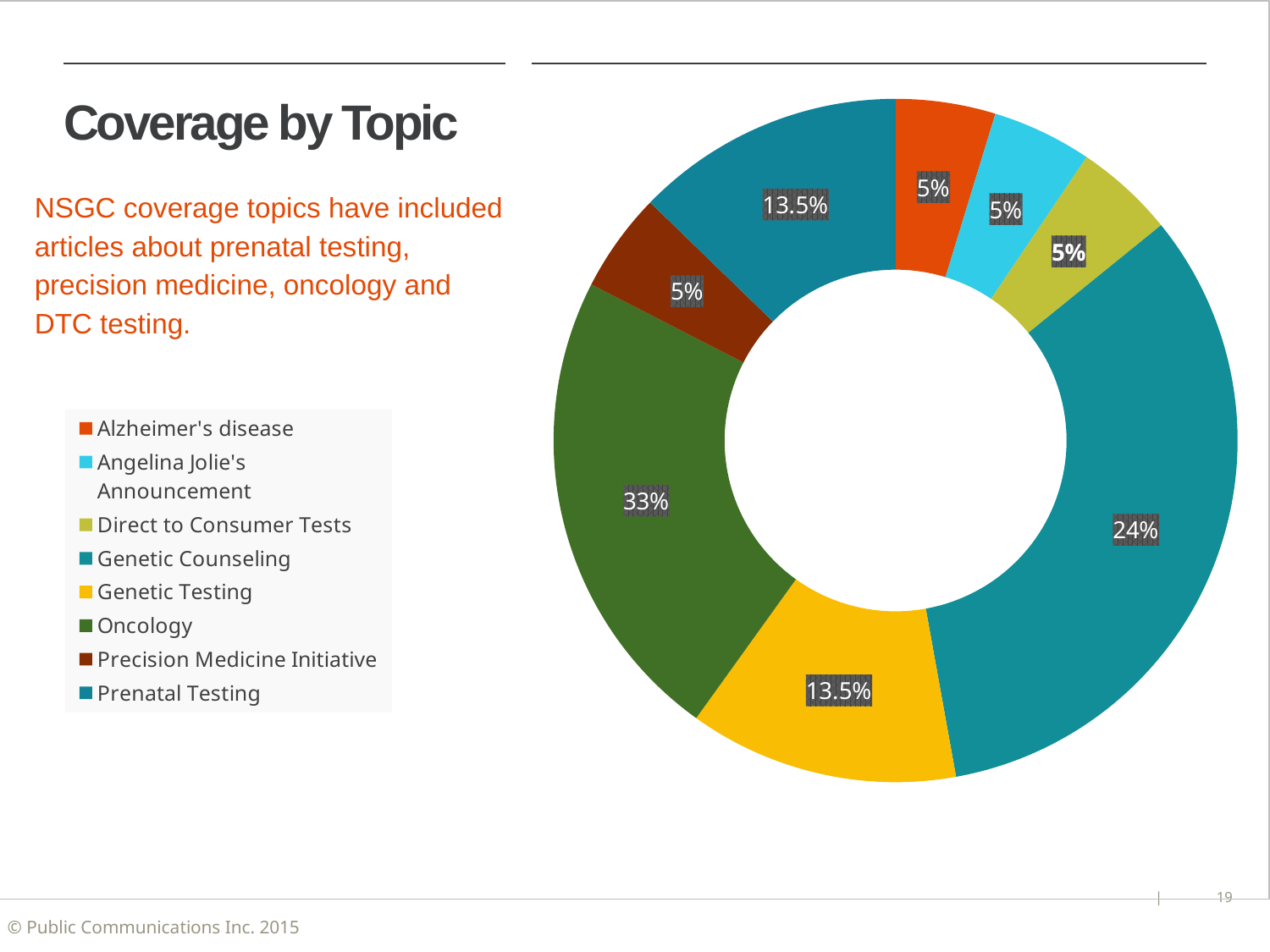
Which is larger, the share for Genetic Counseling or the share for Genetic Testing? Genetic Counseling What percentage is shown for Prenatal Testing? 13.5% What percentage is shown for Alzheimer's disease? 5% What share of coverage does Genetic Counseling account for? 24% How many topics does the chart's legend list? 8 What is the combined share of Genetic Testing and Prenatal Testing? 27% What kind of chart is shown on the slide? doughnut chart Which topic has the largest share of coverage? Oncology What percentage is shown for Genetic Testing? 13.5% What share of coverage does Oncology account for? 33% What is the title of the chart on the slide? Coverage by Topic What is the difference in percentage points between Oncology and Genetic Counseling? 9